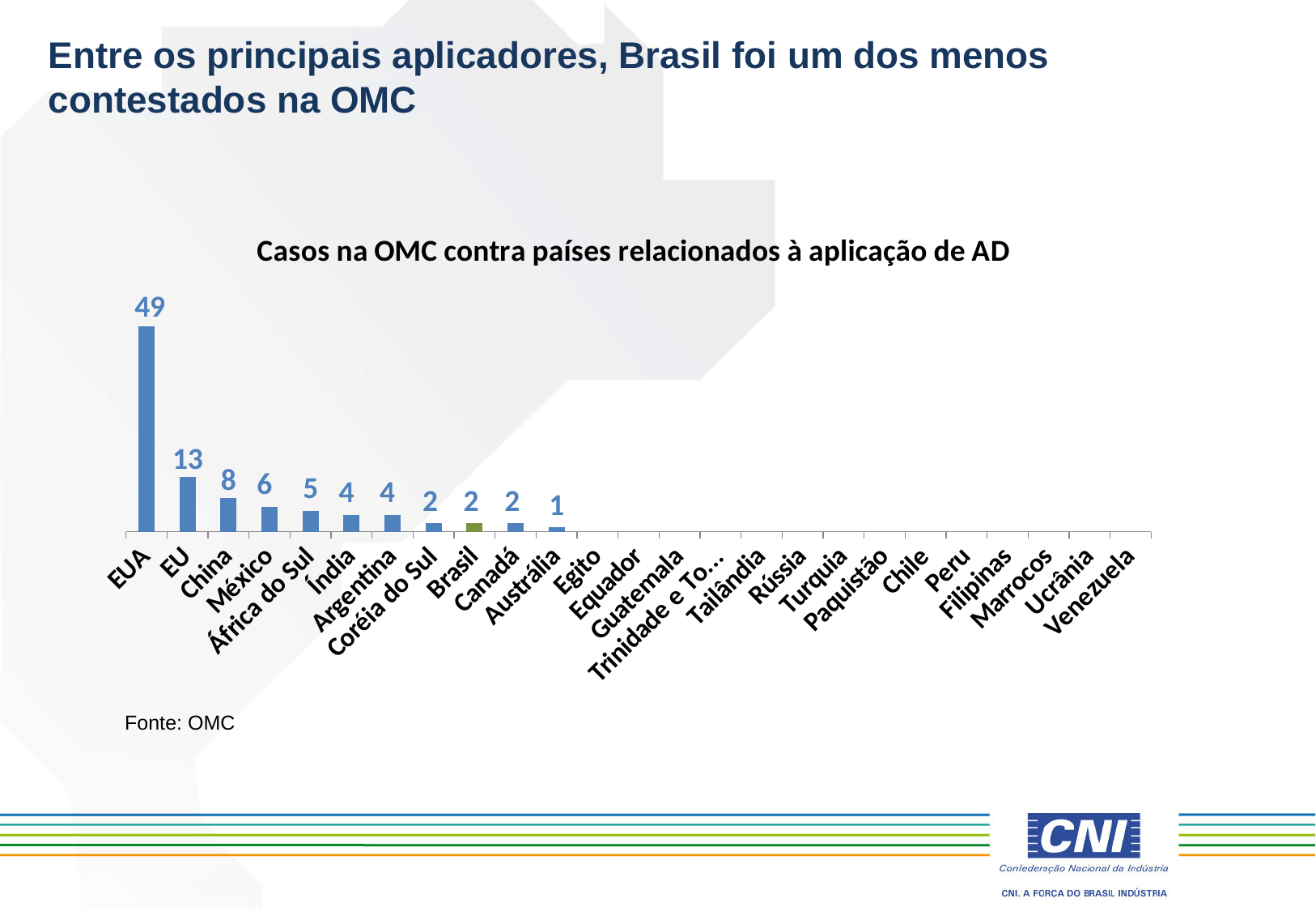
Which category has the highest value? EUA What is the value for Brasil? 2 Which bar is coloured differently (green) from the others? Brasil What is the value for EU? 13 What is the difference between the values for EUA and EU? 36 Do the values rise or fall moving from left to right along the x axis? Fall What is the difference between the values for China and Brasil? 6 What kind of chart is shown on the slide? Bar chart What is the value for EUA? 49 What is the value for África do Sul? 5 Which is larger, the value for México or the value for Índia? México What is the value for China? 8